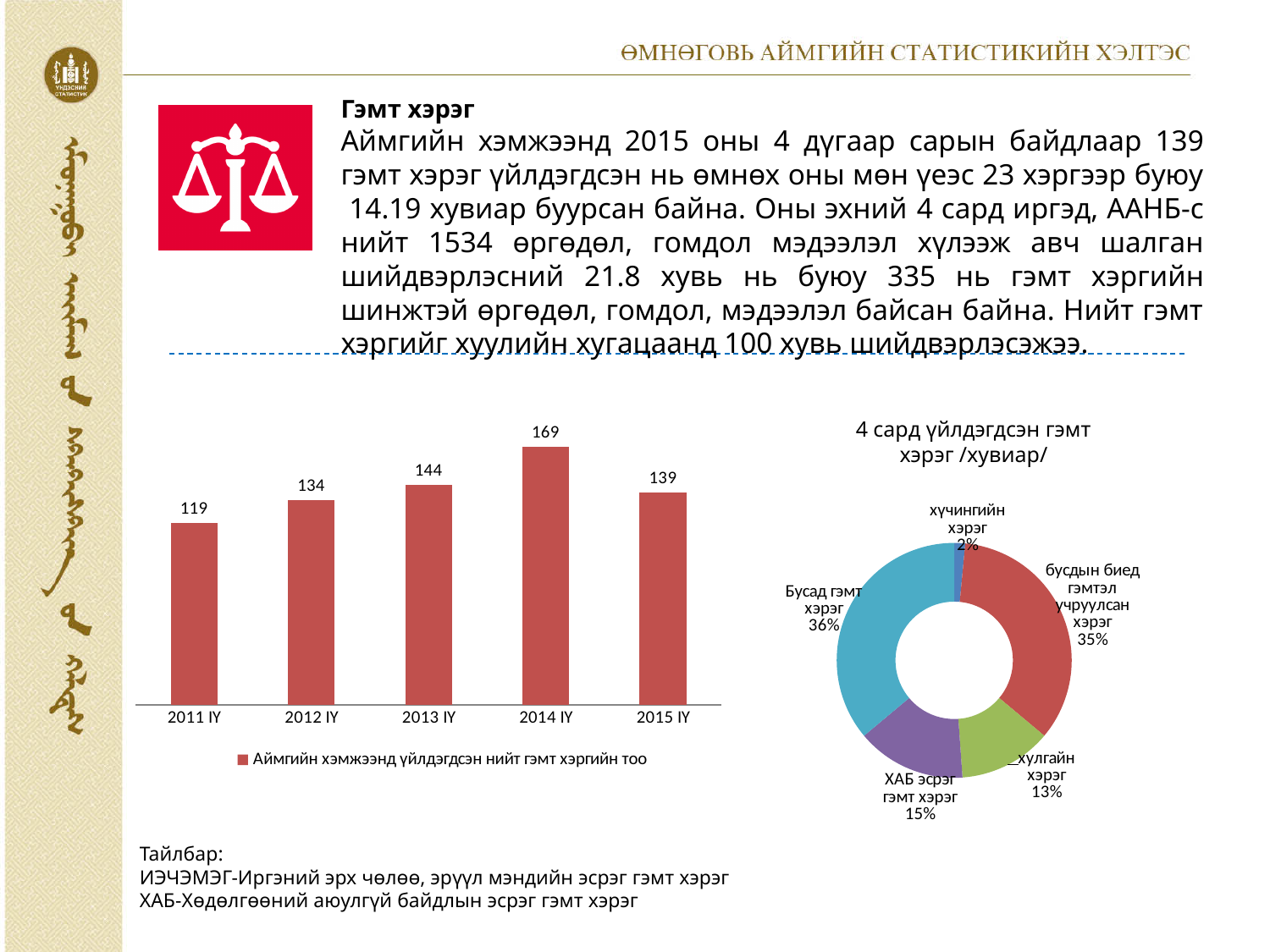
In the bar chart on the left, what is the difference between the values for 2014 IY and 2015 IY? 30 What kind of chart is the chart on the left of the slide? Bar chart In the bar chart on the left, what is the value for 2014 IY? 169 In the bar chart on the left, what is the value for 2011 IY? 119 How many years are shown in the bar chart on the left? 5 In the chart titled '4 сард үйлдэгдсэн гэмт хэрэг /хувиар/', what share is 'хулгайн хэрэг'? 13% In the bar chart on the left, which year has the highest value? 2014 IY How many categories are shown in the chart titled '4 сард үйлдэгдсэн гэмт хэрэг /хувиар/'? 5 In the bar chart on the left, which year has the lowest value? 2011 IY In the chart titled '4 сард үйлдэгдсэн гэмт хэрэг /хувиар/', which category has the smallest share? хүчингийн хэрэг In the bar chart on the left, do the values rise or fall from 2011 IY to 2014 IY? Rise In the bar chart on the left, which is larger, the value for 2013 IY or the value for 2015 IY? 2013 IY